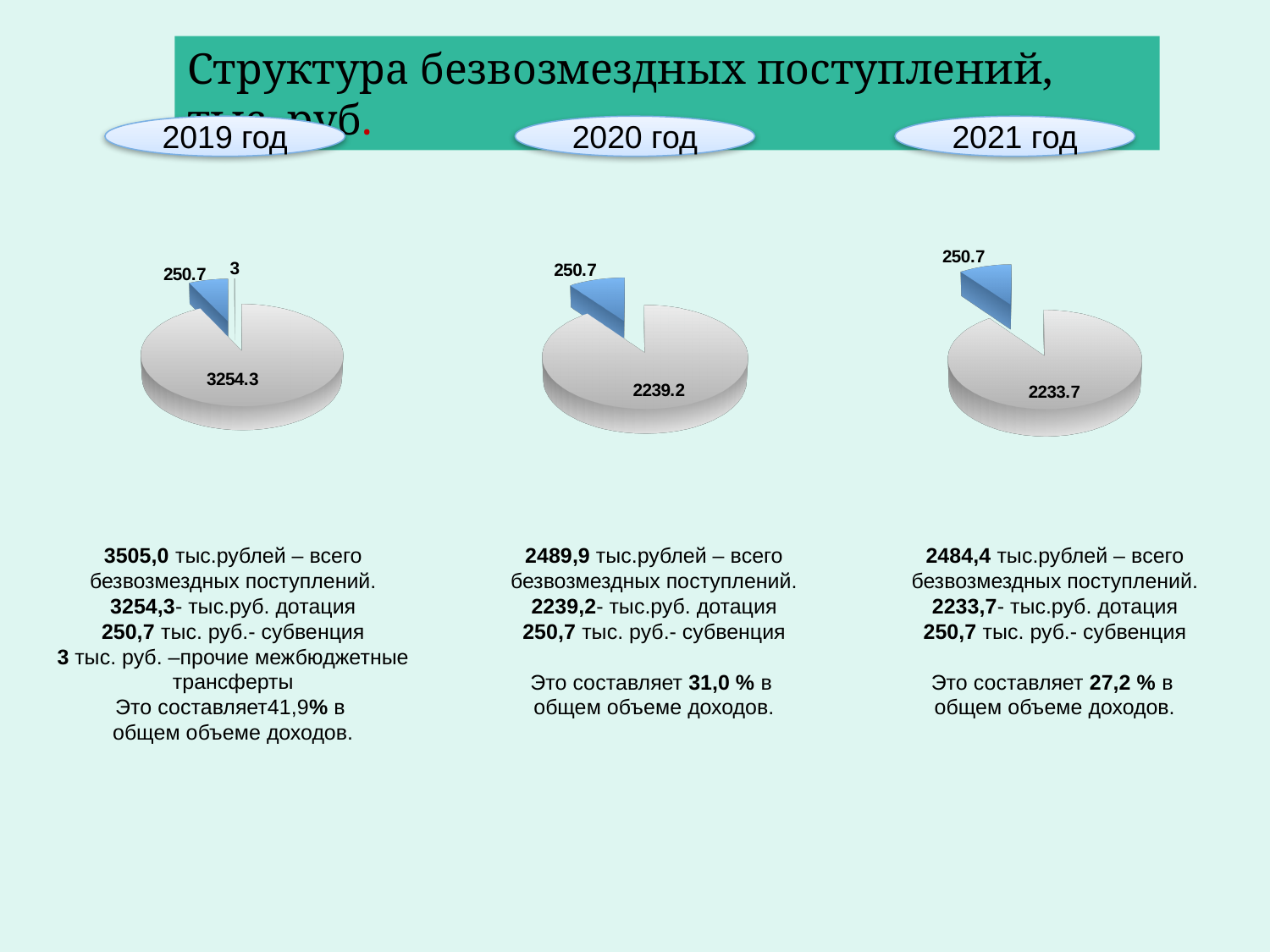
In the 2019 год pie chart, what is the difference between the 3254.3 slice and the 250.7 slice? 3003.6 In the 2019 год pie chart, what is the value of the largest slice? 3254.3 What kind of chart is used for each year on this slide? Pie chart What is the difference between the largest slice of the 2020 год pie chart and the largest slice of the 2021 год pie chart? 5.5 How many slices does the 2019 год pie chart have? 3 In the 2021 год pie chart, what is the value of the grey slice? 2233.7 In the 2020 год pie chart, what is the value of the blue slice? 250.7 How many slices does the 2021 год pie chart have? 2 Which is larger: the largest slice in the 2019 год pie chart or the largest slice in the 2020 год pie chart? 2019 год (3254.3) What is the total of the two slices in the 2020 год pie chart? 2489.9 In the 2019 год pie chart, what is the value of the smallest slice? 3 What is the title of the slide containing the pie charts? Структура безвозмездных поступлений, тыс. руб.